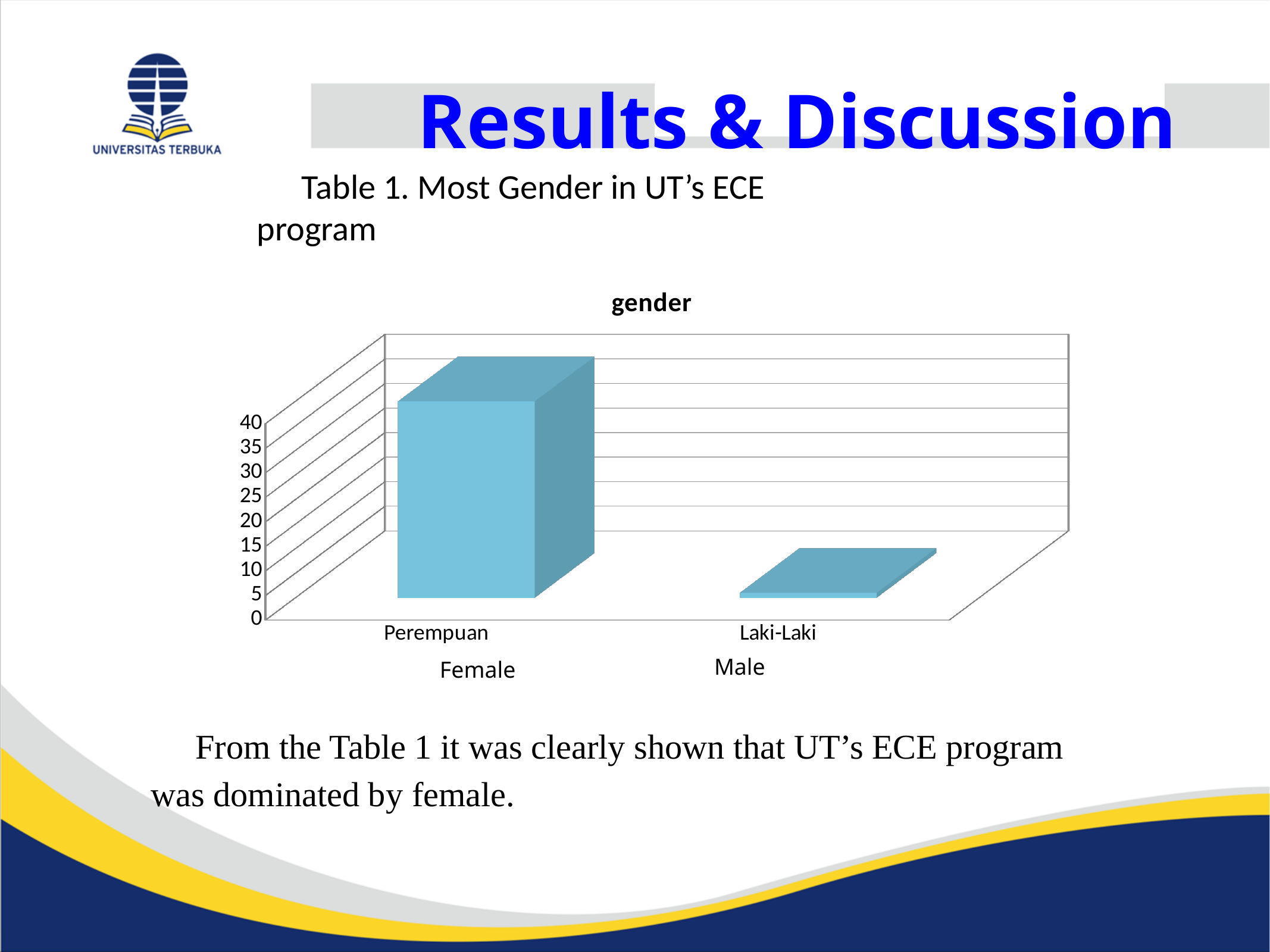
What is the highest tick value shown on the vertical axis of the chart? 40 Is the value for Perempuan greater or less than 20? greater Which category has the highest value in the chart? Perempuan What is the title of the chart? gender Which category has the lowest value in the chart? Laki-Laki What kind of chart is shown on the slide? bar chart Is the value for Perempuan greater or less than 30? greater How many categories are plotted in the chart? 2 Which is larger, the value for Perempuan or the value for Laki-Laki? Perempuan Is the value for Laki-Laki greater or less than 10? less